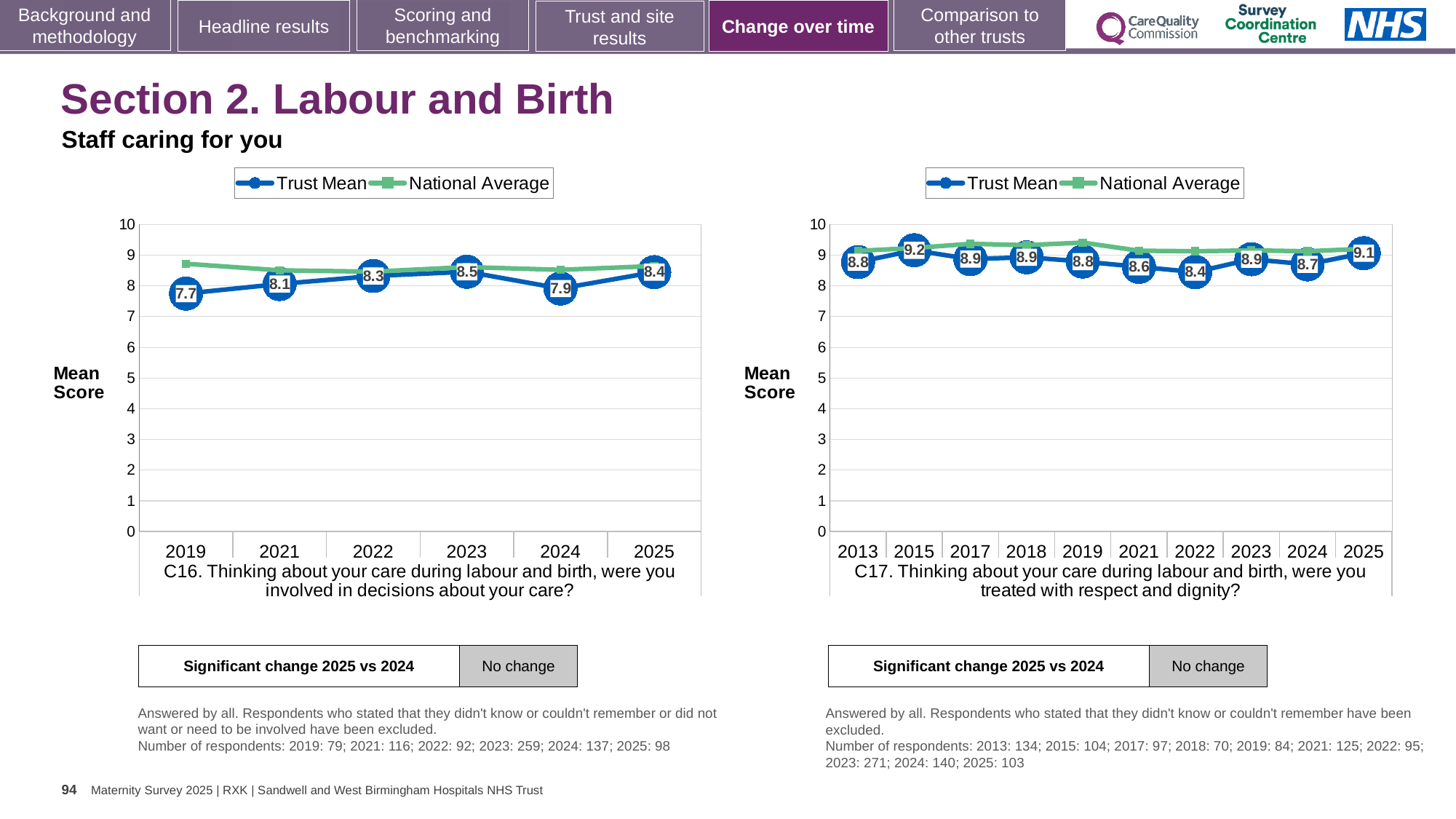
In the C16 chart on the left, what is the Trust Mean score for 2019? 7.7 In the C17 chart on the right, what is the Trust Mean score for 2025? 9.1 In the C16 chart on the left, is the National Average value for 2019 greater or less than 8? greater In the C16 chart on the left, which year has the highest Trust Mean score? 2023 In the C17 chart on the right, which year has the lowest Trust Mean score? 2022 In the C17 chart on the right, is the Trust Mean score for 2015 or 2022 larger? 2015 What kind of chart is the C17 chart on the right? Line chart In the C17 chart on the right, which year has the highest Trust Mean score? 2015 In the C16 chart on the left, how many years are plotted on the x axis? 6 In the C16 chart on the left, what is the Trust Mean score for 2024? 7.9 In the C16 chart on the left, what is the difference between the Trust Mean scores for 2023 and 2019? 0.8 In the C17 chart on the right, how many series does the legend list? 2